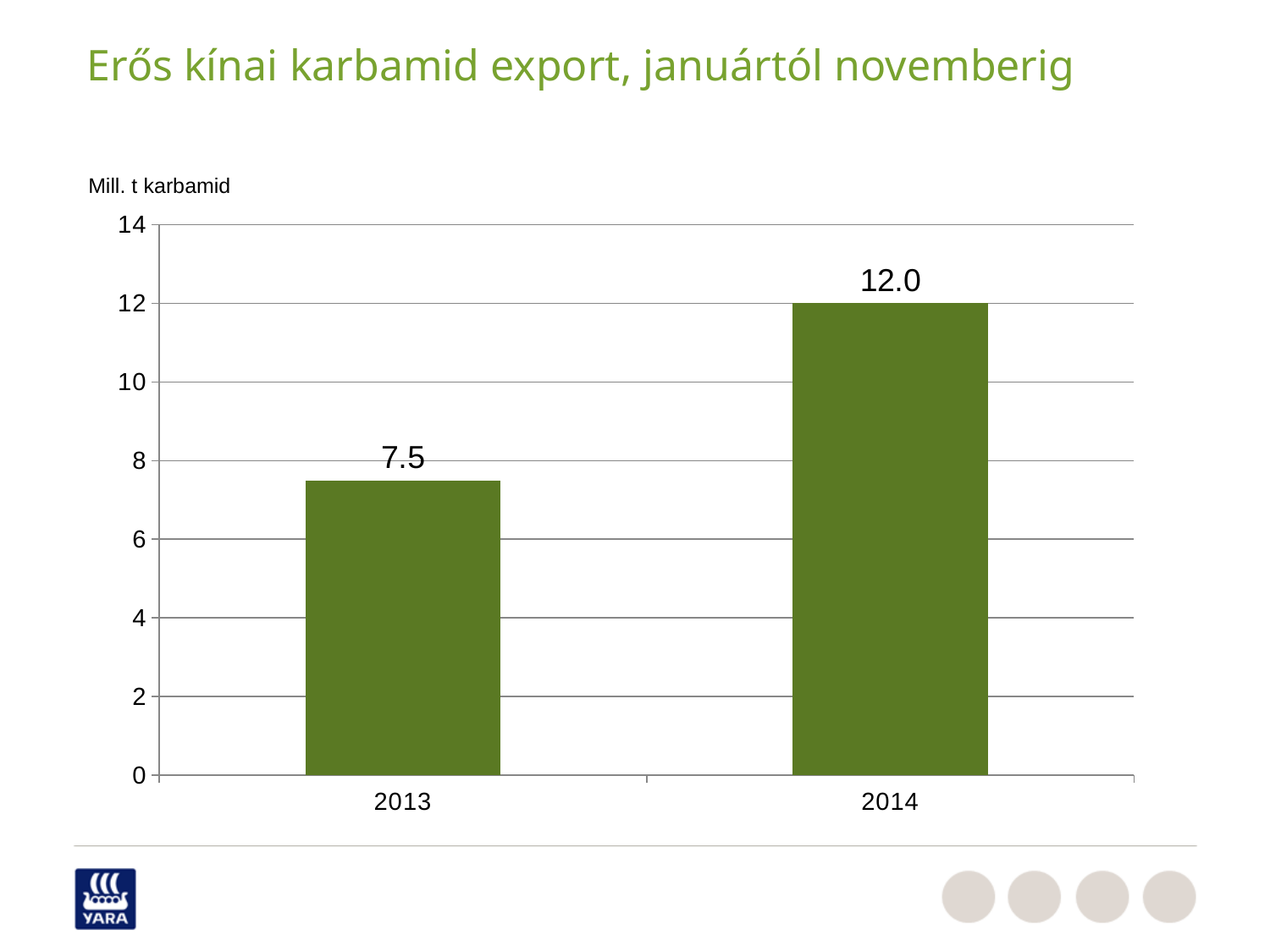
What kind of chart is shown on the slide? bar chart Which year has the highest value? 2014 What is the value for 2013? 7.5 Is the value for 2013 greater or less than 8? less Which is larger, the value for 2013 or the value for 2014? 2014 Which year has the lowest value? 2013 Do the values rise or fall from 2013 to 2014? rise How many bars are shown in the chart? 2 What unit label is shown above the y axis? Mill. t karbamid What is the value for 2014? 12.0 Is the value for 2014 greater or less than 10? greater What is the difference between the values for 2014 and 2013? 4.5